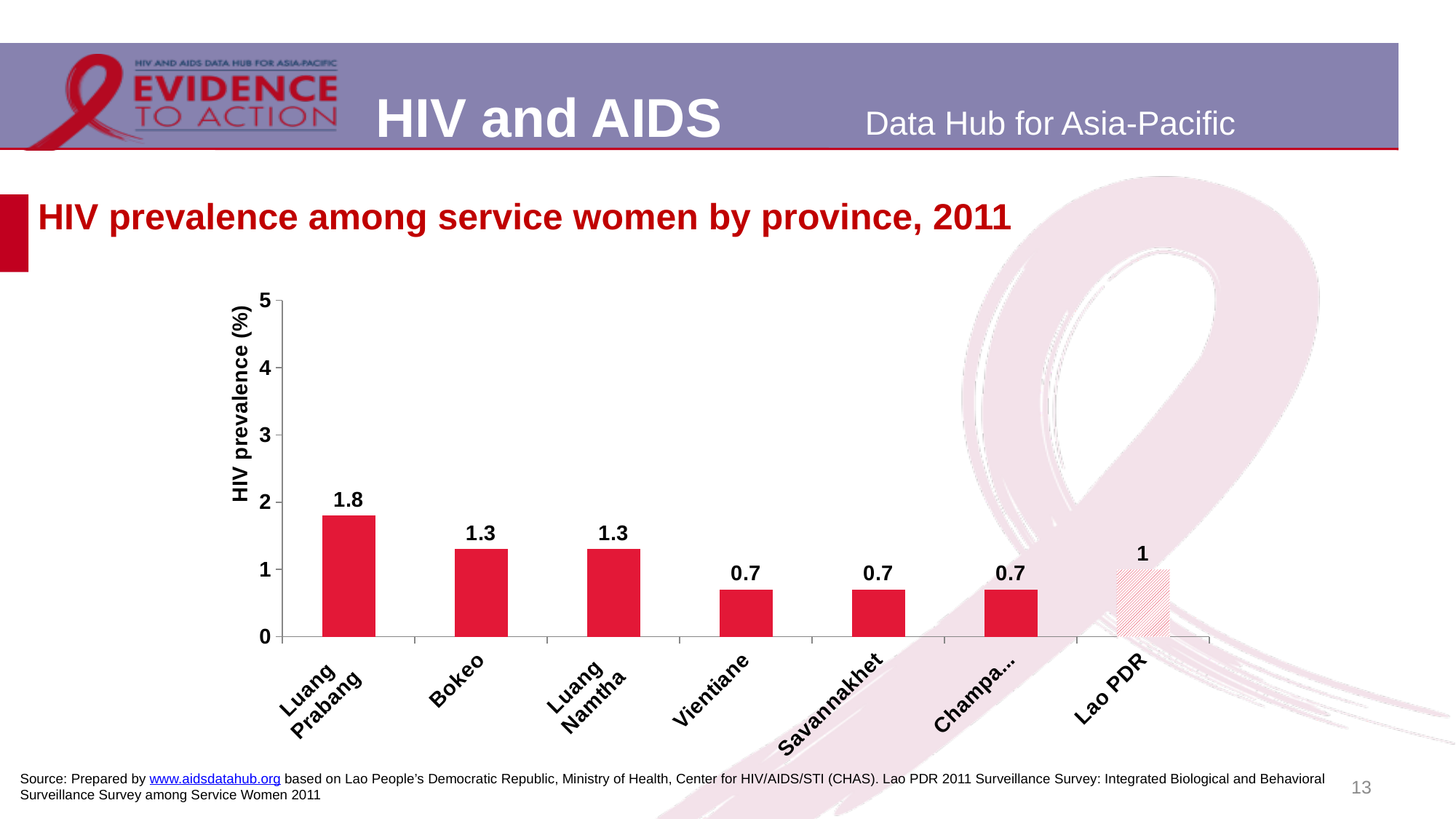
What is the difference between the values for Luang Prabang and Bokeo? 0.5 What is the difference between the values for Lao PDR and Savannakhet? 0.3 How many bars are plotted in the chart? 7 What kind of chart is shown on the slide? bar chart What is the label of the vertical axis? HIV prevalence (%) What is the HIV prevalence value shown for Luang Prabang? 1.8 Which has a larger value, Luang Namtha or Savannakhet? Luang Namtha What is the HIV prevalence value shown for Vientiane? 0.7 What is the HIV prevalence value shown for Bokeo? 1.3 Which province has the highest HIV prevalence among service women in the chart? Luang Prabang Is the value for Luang Prabang greater or less than 2? less What is the HIV prevalence value shown for Lao PDR? 1